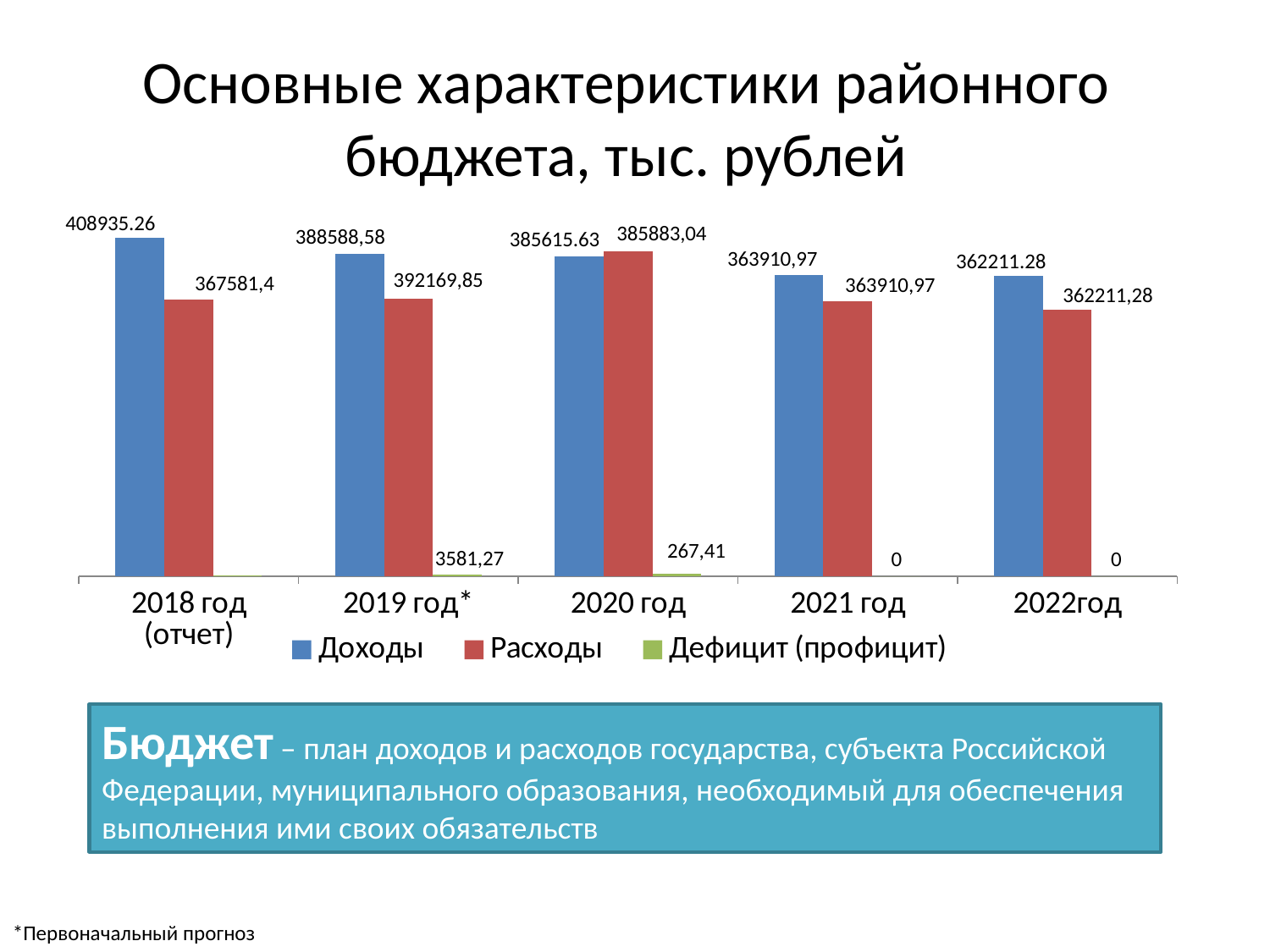
What is the value of Расходы for 2019 год*? 392169,85 How many years are shown on the x axis? 5 Which year has the lowest value of Расходы? 2022год What is the value of Доходы for 2018 год (отчет)? 408935.26 What is the value of Расходы for 2022год? 362211,28 What is the difference between Расходы and Доходы for 2019 год*? 3581,27 How many series does the legend list? 3 For 2018 год (отчет), which is larger: Доходы or Расходы? Доходы Do the values of Доходы rise or fall from 2018 год (отчет) to 2022год? Fall What is the value of Дефицит (профицит) for 2020 год? 267,41 What kind of chart is shown on the slide? Bar chart Which year has the highest value of Доходы? 2018 год (отчет)